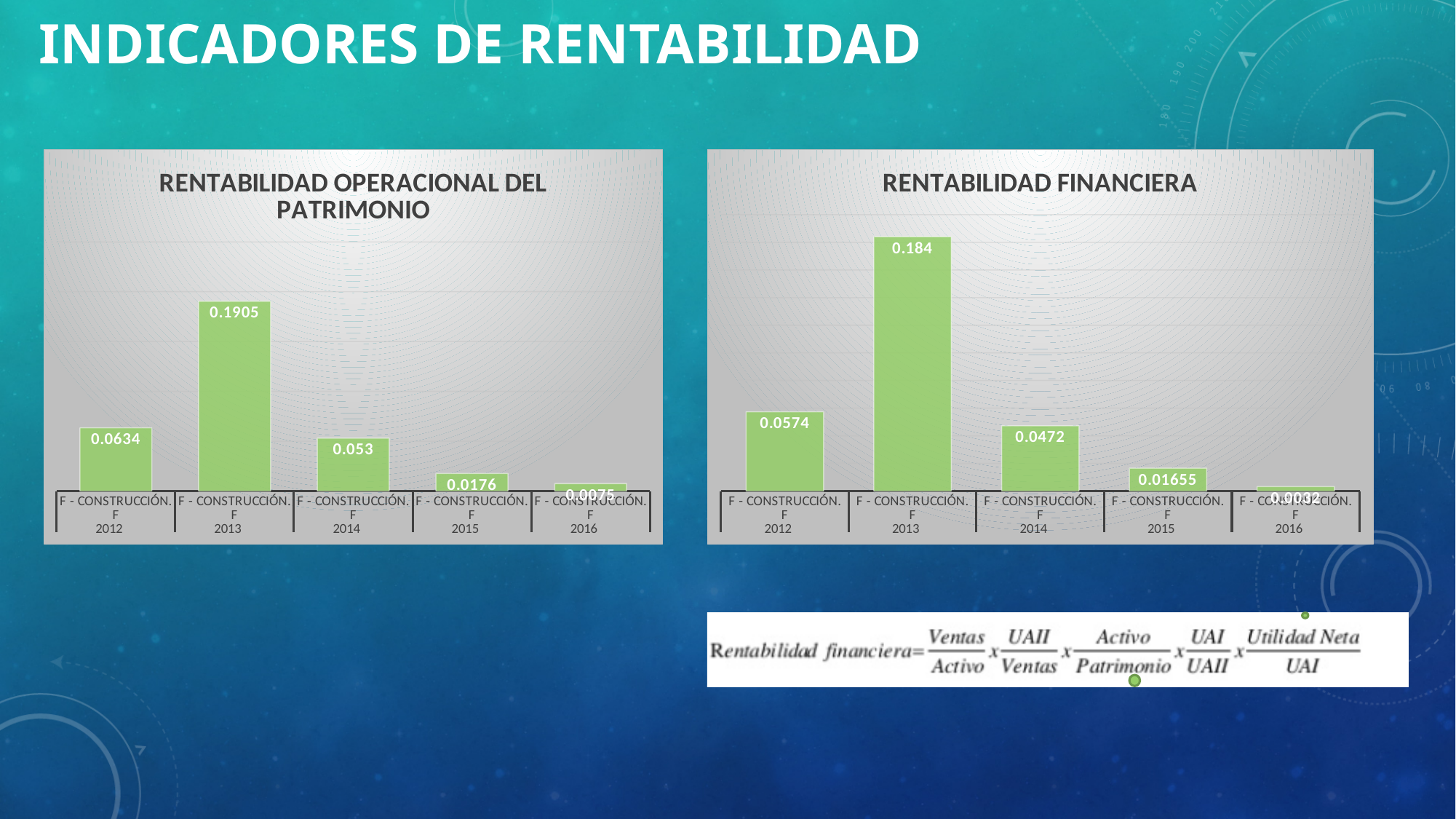
What type of chart is the RENTABILIDAD OPERACIONAL DEL PATRIMONIO chart? Bar chart In the RENTABILIDAD OPERACIONAL DEL PATRIMONIO chart, what is the value for 2012? 0.0634 In the RENTABILIDAD OPERACIONAL DEL PATRIMONIO chart, which year has the highest value? 2013 In the RENTABILIDAD OPERACIONAL DEL PATRIMONIO chart, what is the difference between the 2013 and 2014 values? 0.1375 In the RENTABILIDAD FINANCIERA chart, what is the value for 2015? 0.01655 In the RENTABILIDAD OPERACIONAL DEL PATRIMONIO chart, what is the value for 2015? 0.0176 In the RENTABILIDAD FINANCIERA chart, which year has the lowest value? 2016 How many bars are shown in the RENTABILIDAD FINANCIERA chart? 5 In the RENTABILIDAD FINANCIERA chart, what is the value for 2014? 0.0472 In the RENTABILIDAD OPERACIONAL DEL PATRIMONIO chart, what is the value for 2013? 0.1905 In the RENTABILIDAD FINANCIERA chart, what is the value for 2013? 0.184 In the RENTABILIDAD FINANCIERA chart, which is larger, the value for 2012 or the value for 2014? 2012